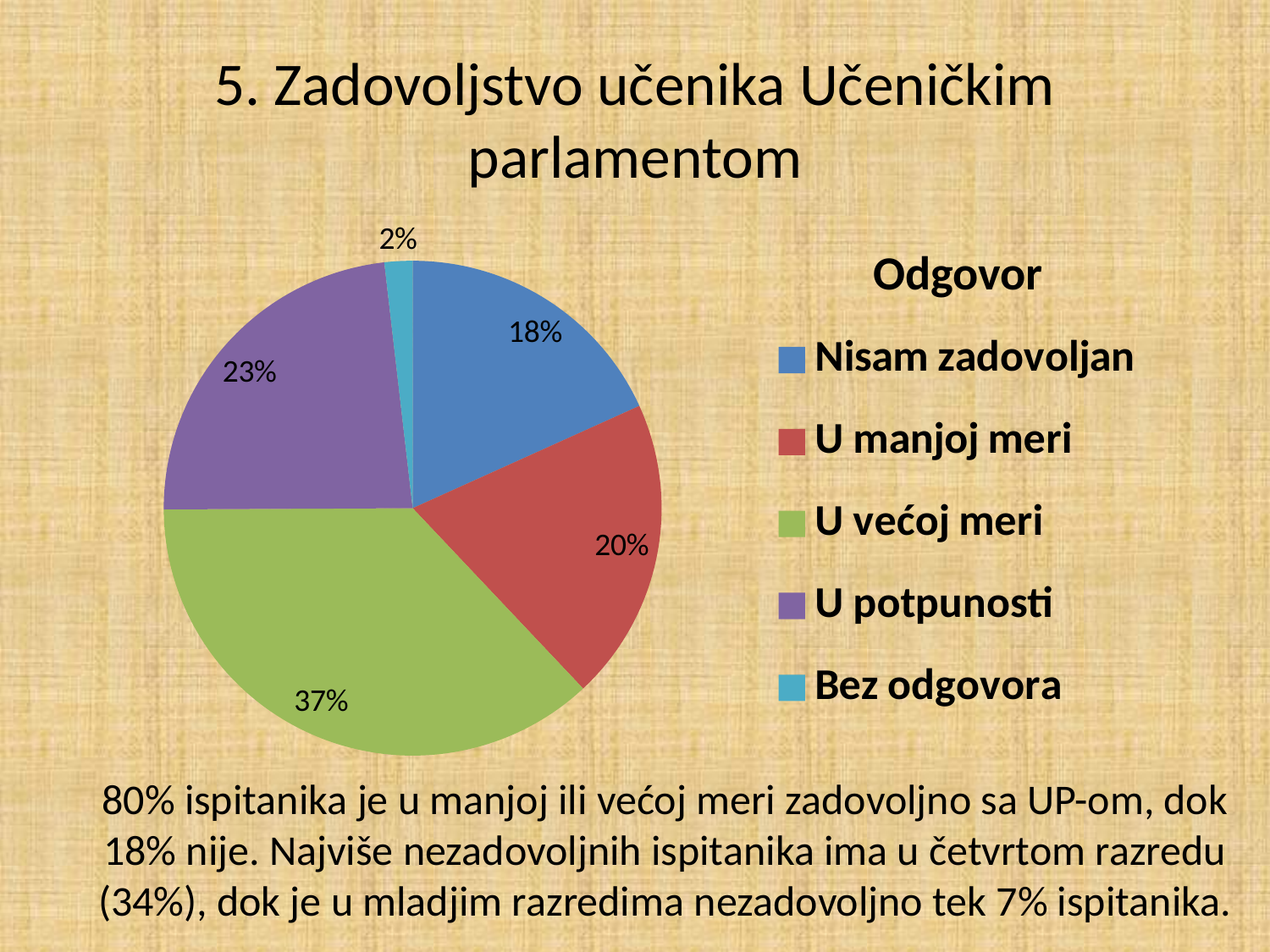
What kind of chart is shown on the slide? pie chart What share of the pie does "U većoj meri" take? 37% What share of the pie does "Bez odgovora" take? 2% What share of the pie does "U manjoj meri" take? 20% What is the difference between the shares of "U većoj meri" and "U potpunosti"? 14% How many categories does the pie chart have? 5 Which category has the largest slice of the pie? U većoj meri What is the title of the chart's legend? Odgovor Which category has the smallest slice of the pie? Bez odgovora Which is larger, the share for "U potpunosti" or the share for "U manjoj meri"? U potpunosti